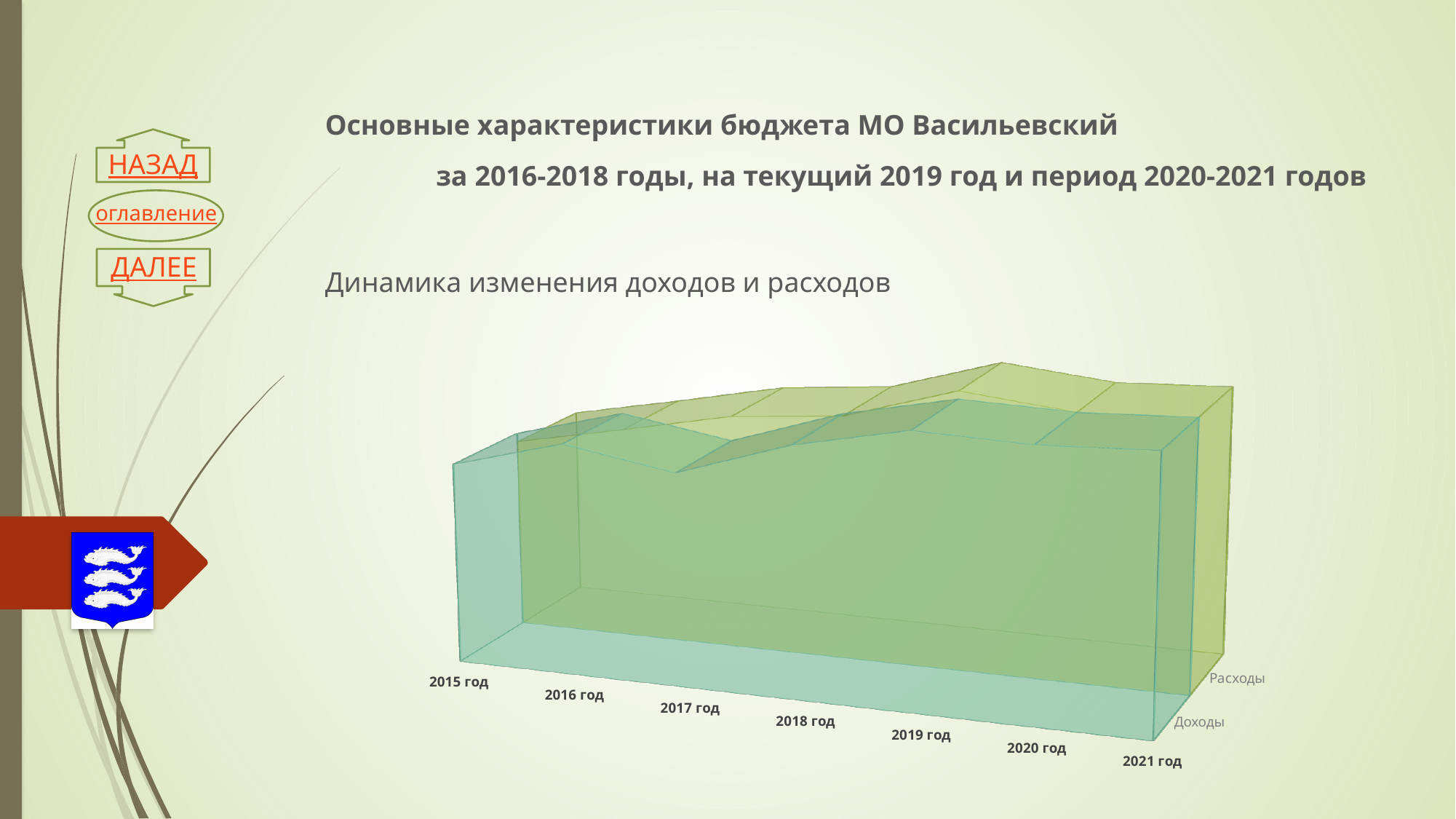
How many years are shown along the x axis of the chart? 7 How many series does the chart show? 2 What is the first year shown on the x axis of the chart? 2015 год What are the names of the two series in the chart? Расходы and Доходы What kind of chart is shown on the slide? area chart What is the title of the chart? Динамика изменения доходов и расходов What is the last year shown on the x axis of the chart? 2021 год